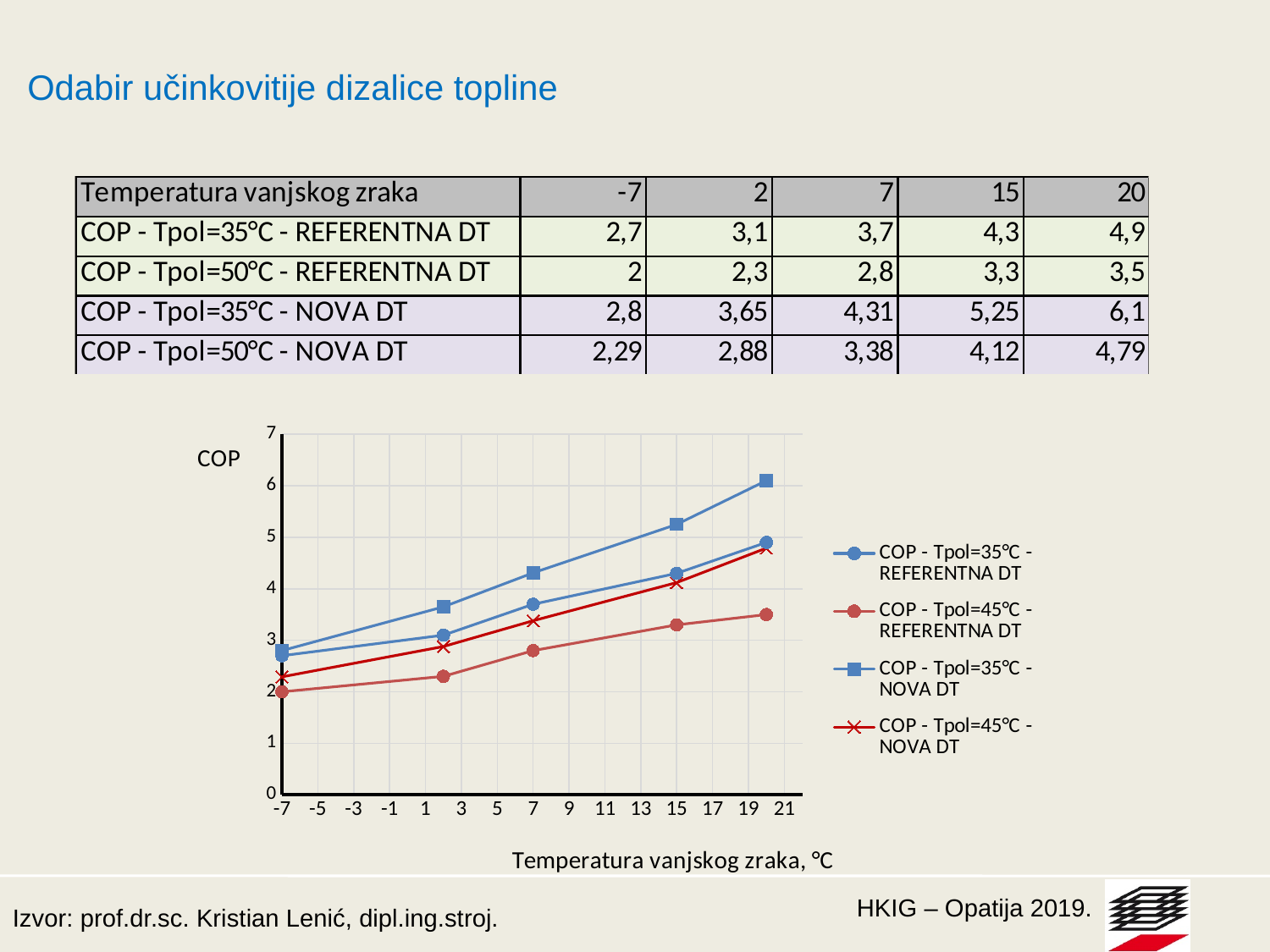
Which series has the lowest COP at -7 °C? COP - Tpol=45°C - REFERENTNA DT What is the title of the chart's x axis? Temperatura vanjskog zraka, °C What label is shown on the chart's y axis? COP At 15 °C, which series has the higher COP: COP - Tpol=35°C - NOVA DT or COP - Tpol=35°C - REFERENTNA DT? COP - Tpol=35°C - NOVA DT How many data points are plotted for the COP - Tpol=35°C - NOVA DT series? 5 Is the value for COP - Tpol=45°C - REFERENTNA DT at 20 °C greater or less than 4? less Is the value for COP - Tpol=35°C - REFERENTNA DT at 7 °C greater or less than 3? greater Is the value for COP - Tpol=35°C - NOVA DT at 20 °C greater or less than 5? greater Does the COP for the COP - Tpol=35°C - NOVA DT series rise or fall as the outdoor air temperature increases? rise Which series reaches the highest COP at 20 °C? COP - Tpol=35°C - NOVA DT How many series does the chart legend list? 4 What type of chart is shown on the slide? line chart